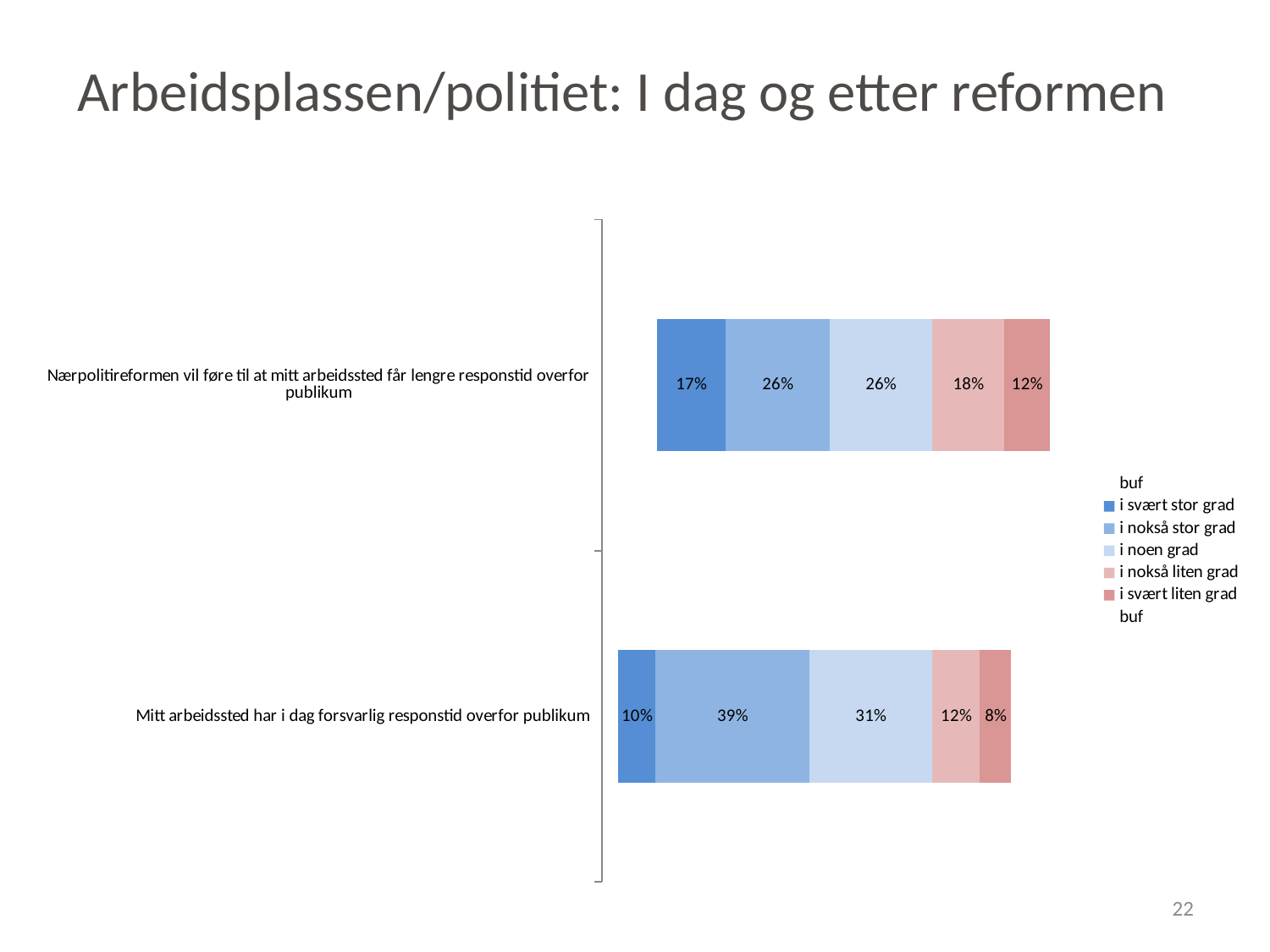
What is the title of the slide? Arbeidsplassen/politiet: I dag og etter reformen How many category bars does the chart show? 2 What kind of chart is shown on the slide? stacked bar chart What is the value for "i nokså liten grad" in the bar "Nærpolitireformen vil føre til at mitt arbeidssted får lengre responstid overfor publikum"? 18% What is the value for "i svært liten grad" in the bar "Mitt arbeidssted har i dag forsvarlig responstid overfor publikum"? 8% Which bar has the larger "i svært stor grad" value? Nærpolitireformen vil føre til at mitt arbeidssted får lengre responstid overfor publikum What is the total of the segments in the bar "Mitt arbeidssted har i dag forsvarlig responstid overfor publikum"? 100% Which segment is the smallest in the bar "Nærpolitireformen vil føre til at mitt arbeidssted får lengre responstid overfor publikum"? i svært liten grad What is the value for "i nokså stor grad" in the bar "Mitt arbeidssted har i dag forsvarlig responstid overfor publikum"? 39% What is the difference between the "i nokså stor grad" values of the two bars? 13% What is the value for "i svært stor grad" in the bar "Nærpolitireformen vil føre til at mitt arbeidssted får lengre responstid overfor publikum"? 17% Which segment is the largest in the bar "Mitt arbeidssted har i dag forsvarlig responstid overfor publikum"? i nokså stor grad